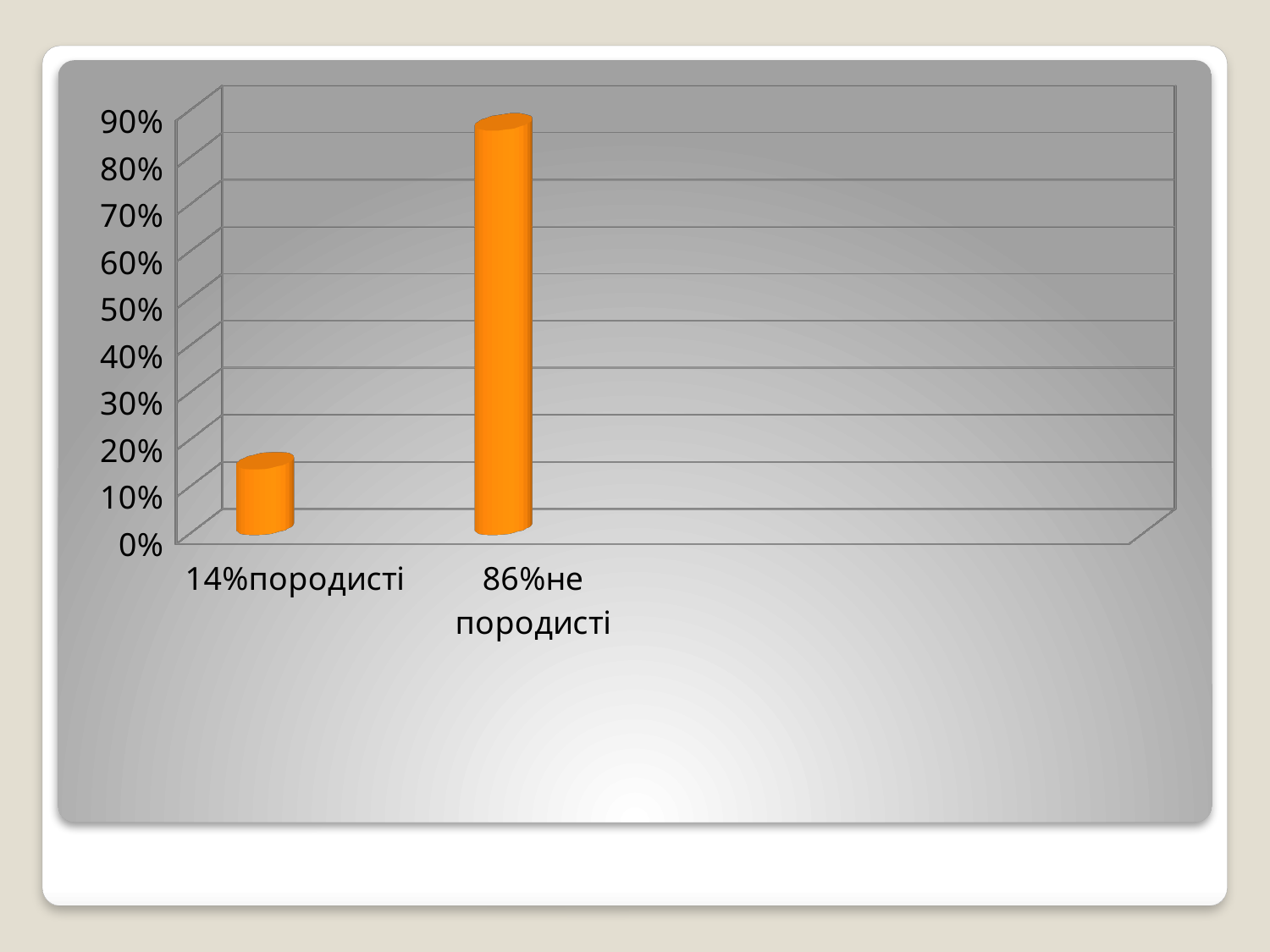
How many categories are shown on the x axis of the chart? 2 Which is larger, the bar for "породисті" or the bar for "не породисті"? не породисті What kind of chart is shown on the slide? bar chart What is the difference between the values for "не породисті" (86%) and "породисті" (14%)? 72% What is the highest tick label shown on the vertical axis of the chart? 90% What colour are the bars in the chart? orange What value is given for the category "не породисті" in the chart? 86% Is the value for "не породисті" greater or less than 80%? greater Is the value for "породисті" greater or less than 20%? less Which category has the lowest bar in the chart? 14%породисті What value is given for the category "породисті" in the chart? 14% Which category has the highest bar in the chart? 86%не породисті